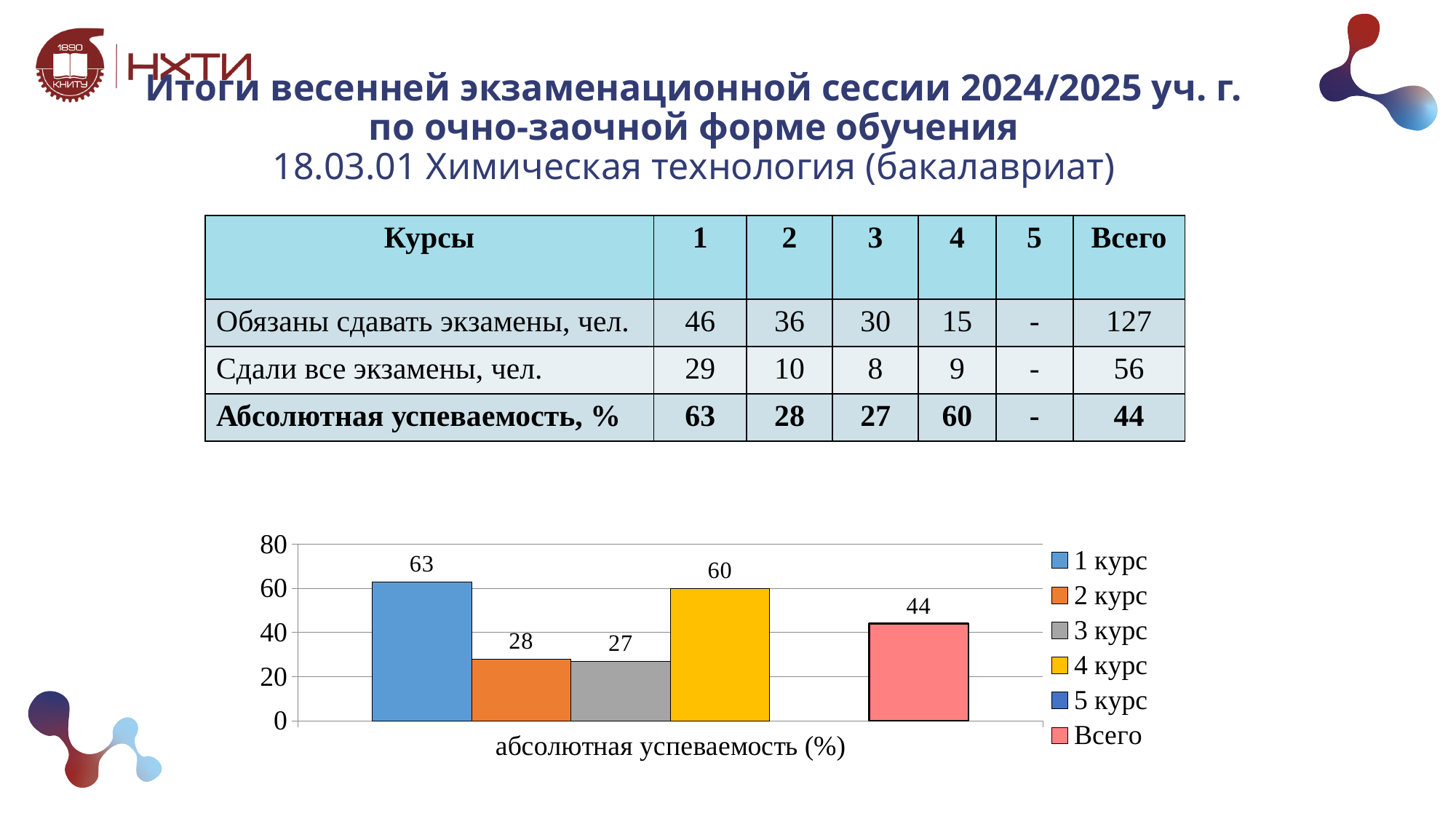
What is the difference between the values for 1 курс and 2 курс in the bar chart? 35 How many series does the legend of the bar chart list? 6 What is the value for 4 курс in the bar chart? 60 Which series has the lowest plotted value in the bar chart? 3 курс What is the value for Всего in the bar chart? 44 What is the value for 1 курс in the bar chart? 63 What kind of chart is shown on the slide? bar chart Which series has the highest value in the bar chart? 1 курс What is the x-axis category label of the bar chart? абсолютная успеваемость (%) What is the value for 3 курс in the bar chart? 27 Which is larger in the bar chart, the value for 4 курс or the value for Всего? 4 курс Is the value for 2 курс in the bar chart greater or less than 40? less